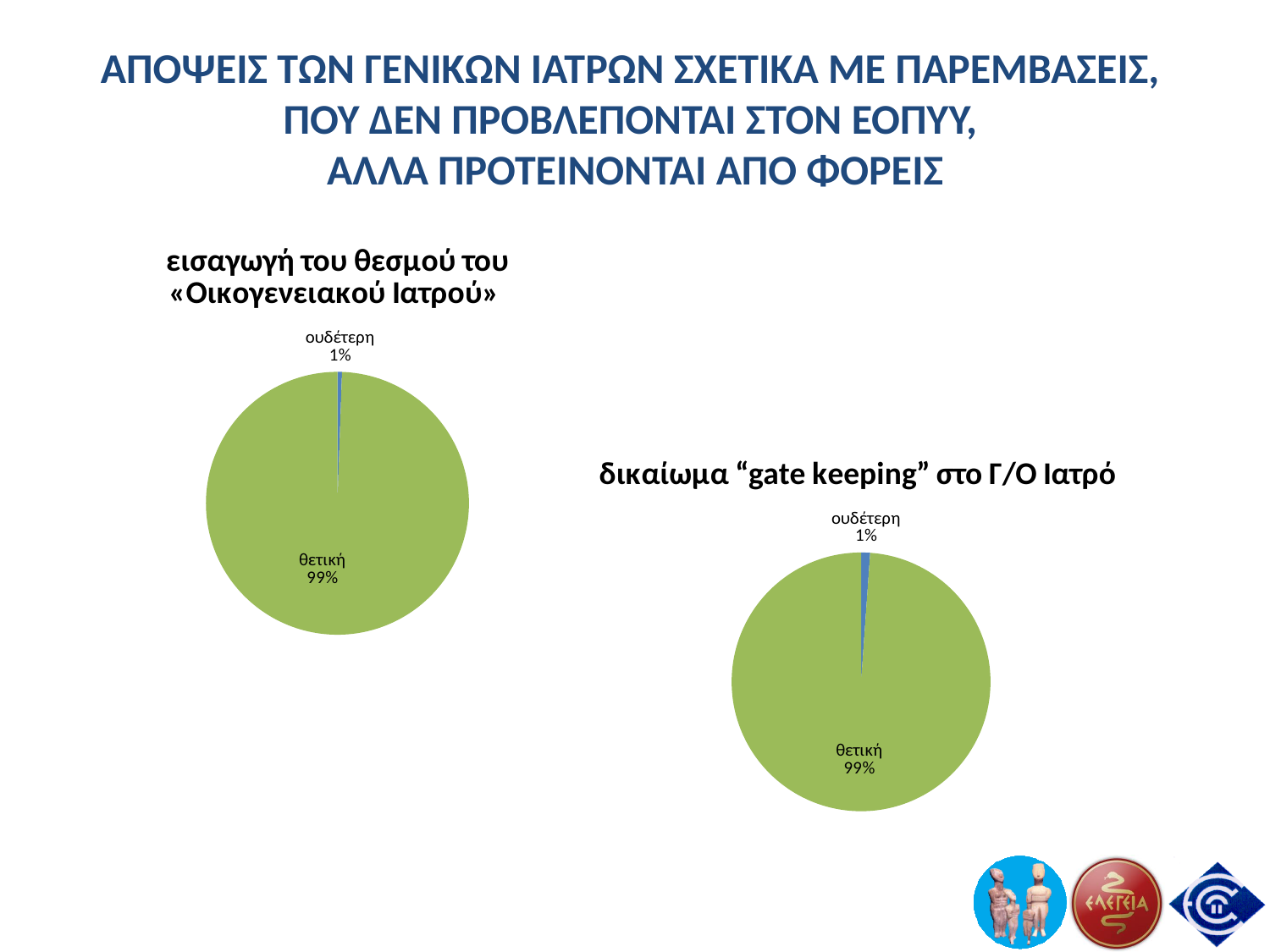
In the right chart titled «δικαίωμα “gate keeping” στο Γ/Ο Ιατρό», which is larger, θετική or ουδέτερη? θετική In the right chart titled «δικαίωμα “gate keeping” στο Γ/Ο Ιατρό», which slice is the smallest? ουδέτερη In the right chart titled «δικαίωμα “gate keeping” στο Γ/Ο Ιατρό», what share does the θετική slice have? 99% What kind of chart is the right chart titled «δικαίωμα “gate keeping” στο Γ/Ο Ιατρό»? Pie chart How many slices does the right chart titled «δικαίωμα “gate keeping” στο Γ/Ο Ιατρό» have? 2 In the left chart titled «εισαγωγή του θεσμού του «Οικογενειακού Ιατρού»», what share does the θετική slice have? 99% In the left chart titled «εισαγωγή του θεσμού του «Οικογενειακού Ιατρού»», what share does the ουδέτερη slice have? 1% In the left chart titled «εισαγωγή του θεσμού του «Οικογενειακού Ιατρού»», what is the difference in percentage points between the θετική and ουδέτερη slices? 98 percentage points In the left chart titled «εισαγωγή του θεσμού του «Οικογενειακού Ιατρού»», which slice is the largest? θετική What colour is the θετική slice in the left chart titled «εισαγωγή του θεσμού του «Οικογενειακού Ιατρού»»? Green How many slices does the left chart titled «εισαγωγή του θεσμού του «Οικογενειακού Ιατρού»» have? 2